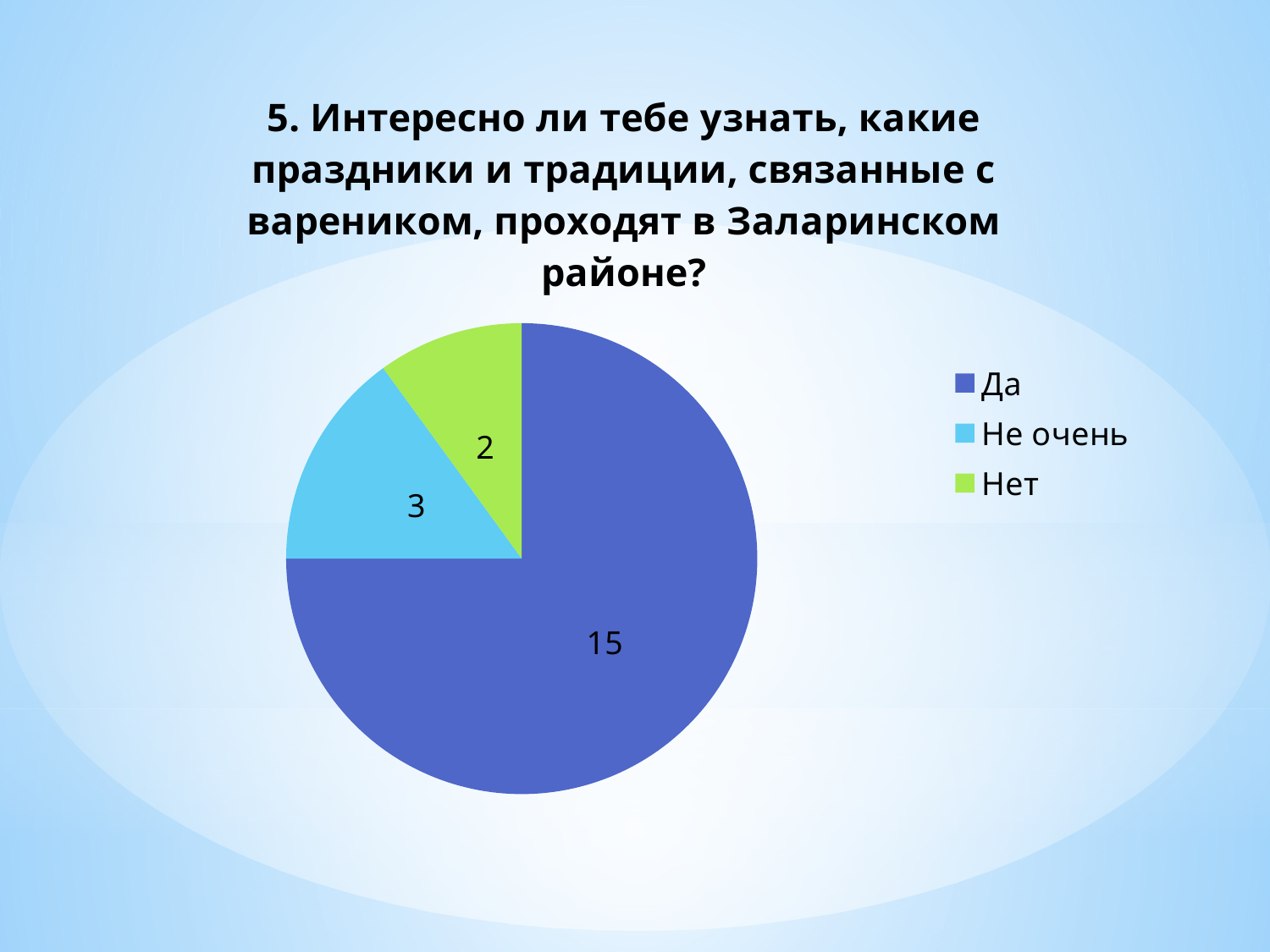
Which is larger, the value for "Не очень" or the value for "Нет"? Не очень What is the value for "Не очень"? 3 Which category has the largest slice? Да What is the total of all slices in the pie chart? 20 What is the value for "Нет"? 2 What is the difference between the values for "Не очень" and "Нет"? 1 What is the difference between the values for "Да" and "Не очень"? 12 How many categories does the pie chart have? 3 What is the value for "Да"? 15 What share of the pie does "Да" represent? 75% What type of chart is shown on the slide? pie chart Which category has the smallest slice? Нет